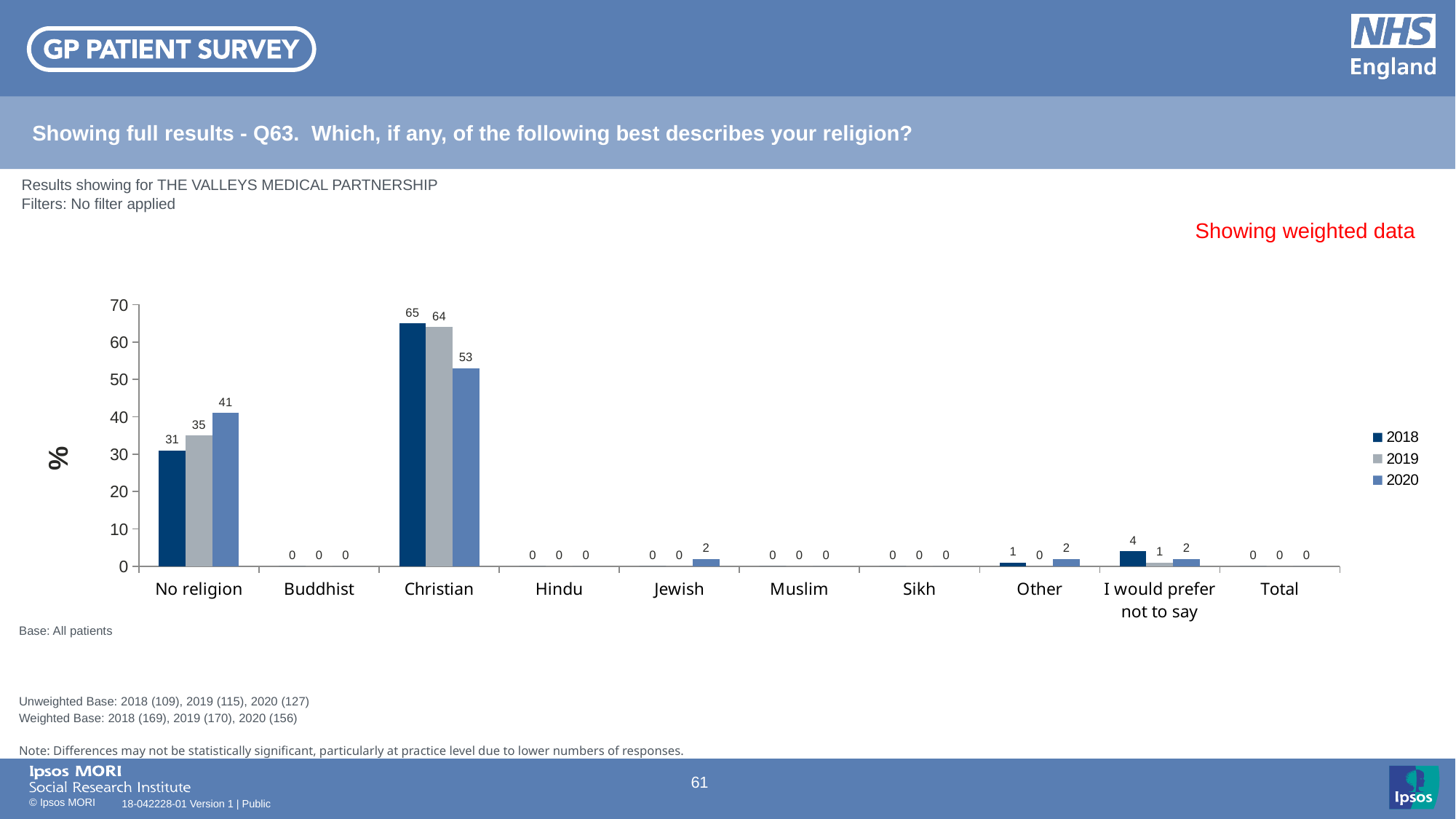
Do the values for No religion rise or fall from 2018 to 2020? Rise How many categories are shown on the x axis? 10 What is the value for Christian in 2018? 65 Which is larger: the 2019 value for No religion or the 2019 value for Christian? Christian What kind of chart is shown on the slide? Bar chart Is the value for Christian in 2020 greater or less than 50? greater How many series does the legend list? 3 What is the difference between the 2020 and 2018 values for No religion? 10 Which category has the highest value in 2019? Christian What is the value for No religion in 2020? 41 What is the difference between the 2018 and 2020 values for Christian? 12 What is the value for 'I would prefer not to say' in 2018? 4